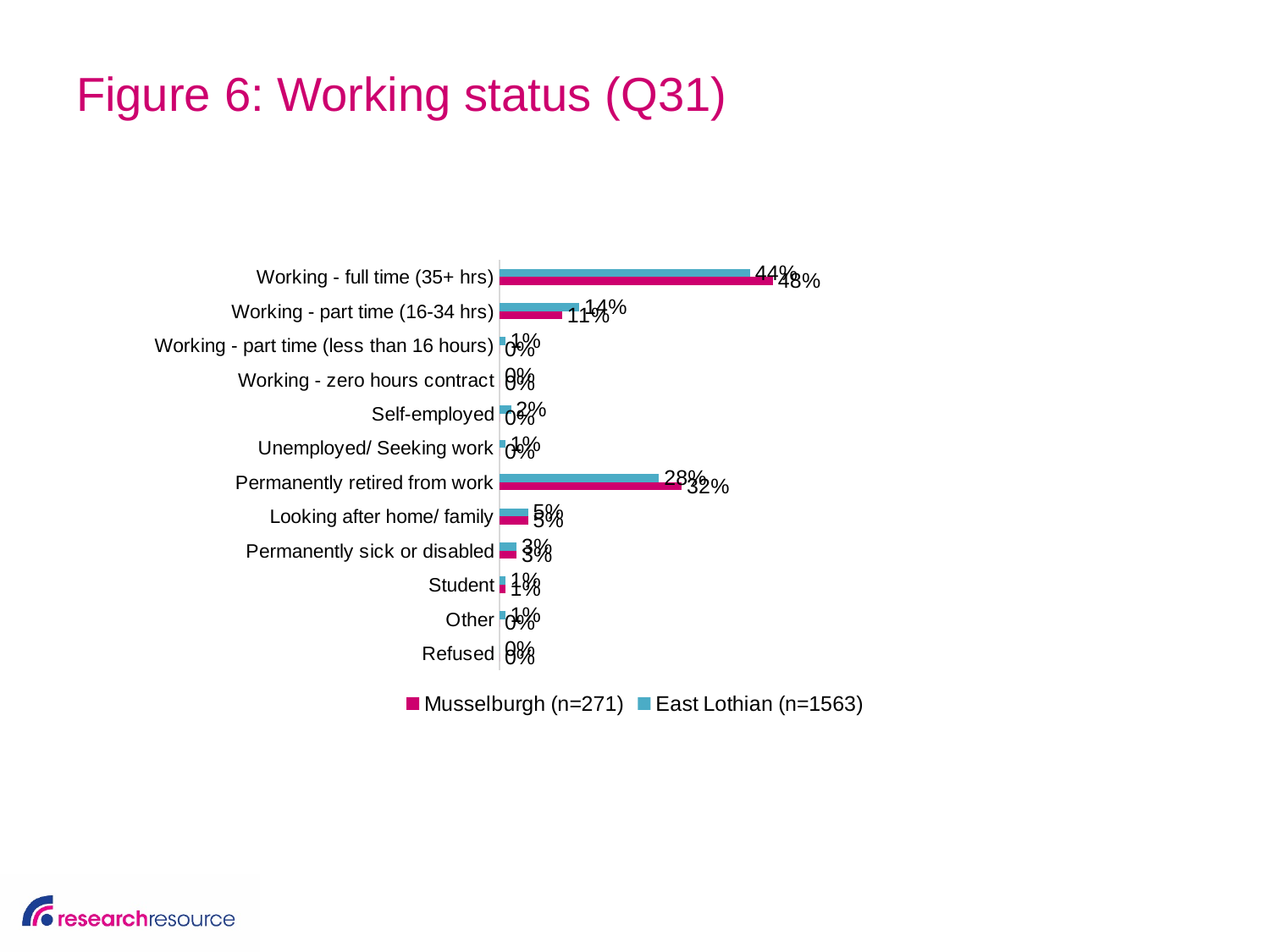
What is the title of the chart on the slide? Figure 6: Working status (Q31) How many series does the legend list? 2 What is the value for Musselburgh (n=271) for 'Working - full time (35+ hrs)'? 48% What is the value for Musselburgh (n=271) for 'Looking after home/ family'? 5% For 'Working - part time (16-34 hrs)', which is larger: the Musselburgh (n=271) value or the East Lothian (n=1563) value? East Lothian (n=1563) Which category has the highest value for Musselburgh (n=271)? Working - full time (35+ hrs) What is the value for East Lothian (n=1563) for 'Working - part time (16-34 hrs)'? 14% How many working status categories are shown on the chart? 12 What is the value for Musselburgh (n=271) for 'Permanently retired from work'? 32% What type of chart is shown on the slide? bar chart What is the value for East Lothian (n=1563) for 'Working - full time (35+ hrs)'? 44% What is the difference between the Musselburgh (n=271) and East Lothian (n=1563) values for 'Permanently retired from work'? 4%